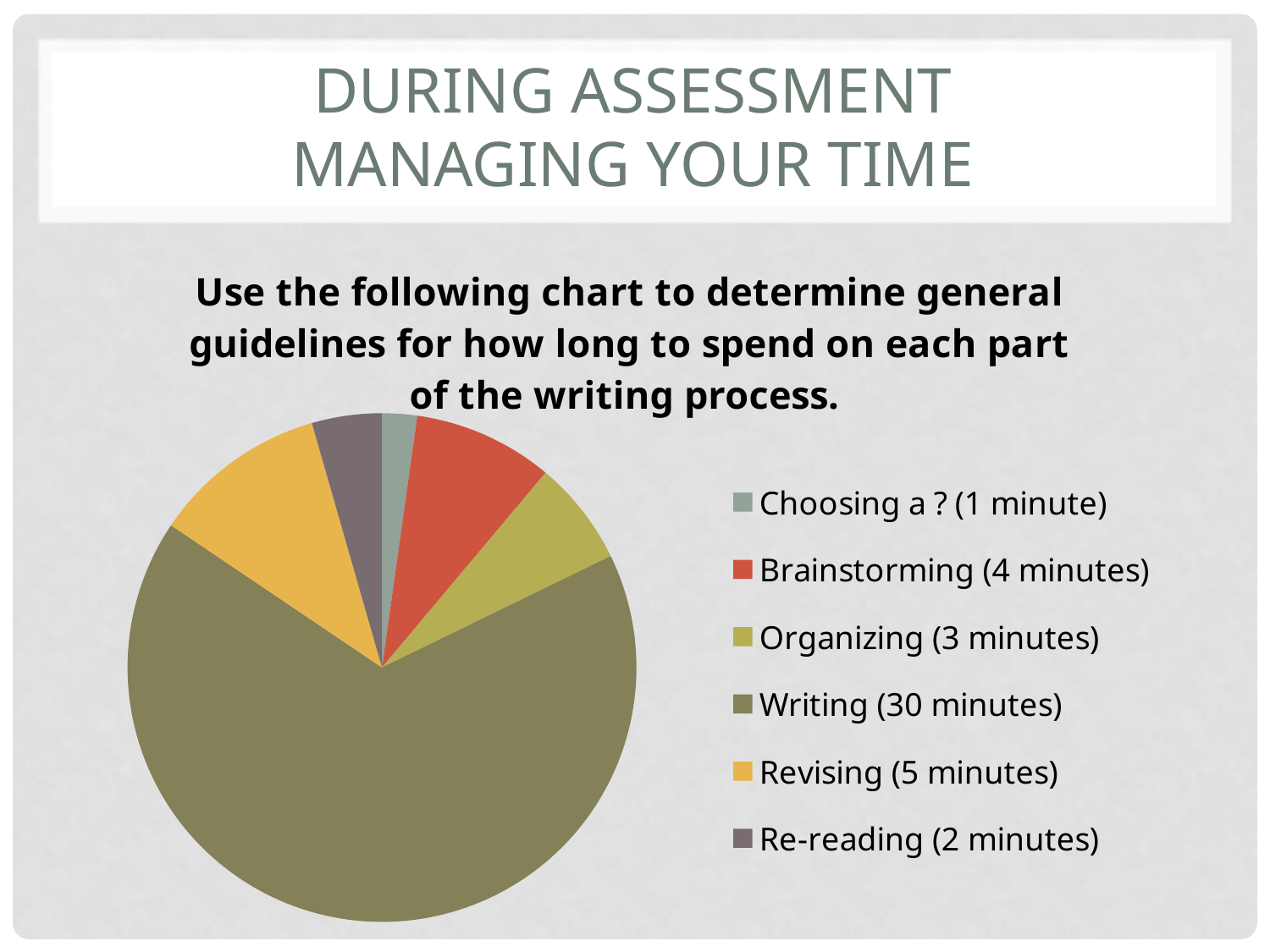
Which part of the writing process takes up the largest slice of the pie? Writing Which is allotted more time, Revising or Organizing? Revising What is the total number of minutes across all parts of the writing process in the legend? 45 minutes How many more minutes are allotted to Writing than to Revising? 25 minutes Which part of the writing process takes up the smallest slice of the pie? Choosing a ? How many slices does the pie chart have? 6 According to the legend, how many minutes are allotted to Writing? 30 minutes What kind of chart is shown on the slide? pie chart According to the legend, how many minutes are allotted to Re-reading? 2 minutes What colour is the Writing slice of the pie chart? olive green What is the title of the slide containing the pie chart? During Assessment Managing Your Time According to the legend, how many minutes are allotted to Brainstorming? 4 minutes